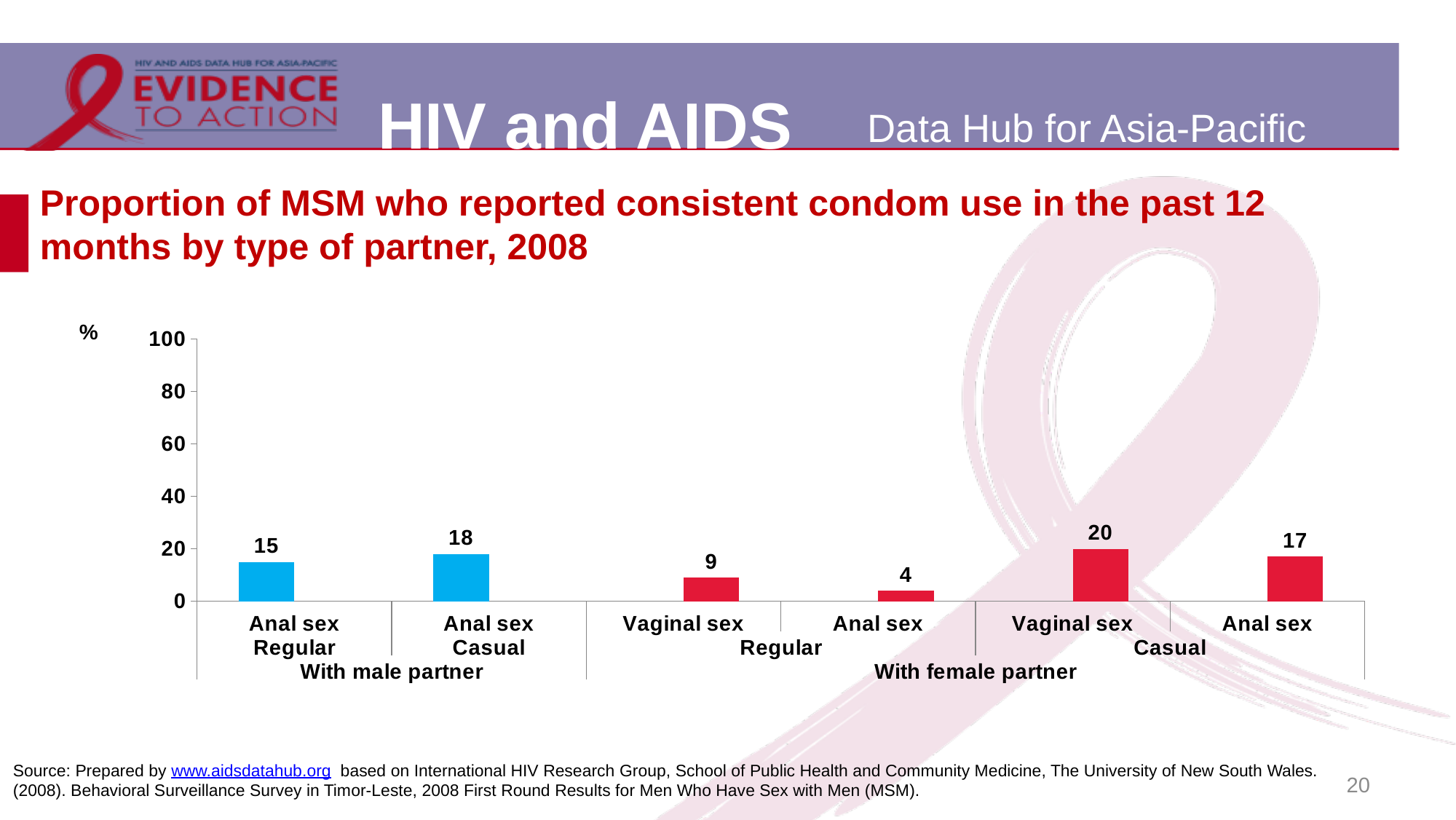
Which category has the lowest value? Anal sex, regular female partner What is the value for anal sex with a casual female partner? 17 What is the value for anal sex with a regular male partner? 15 What is the value for anal sex with a casual male partner? 18 What type of chart is shown on the slide? Bar chart What is the difference between vaginal sex with a casual female partner and vaginal sex with a regular female partner? 11 What is the value for vaginal sex with a casual female partner? 20 Which category has the highest value? Vaginal sex, casual female partner Which is larger: anal sex with a casual male partner or anal sex with a casual female partner? Anal sex with a casual male partner What is the value for vaginal sex with a regular female partner? 9 How many bars are plotted in the chart? 6 What is the value for anal sex with a regular female partner? 4